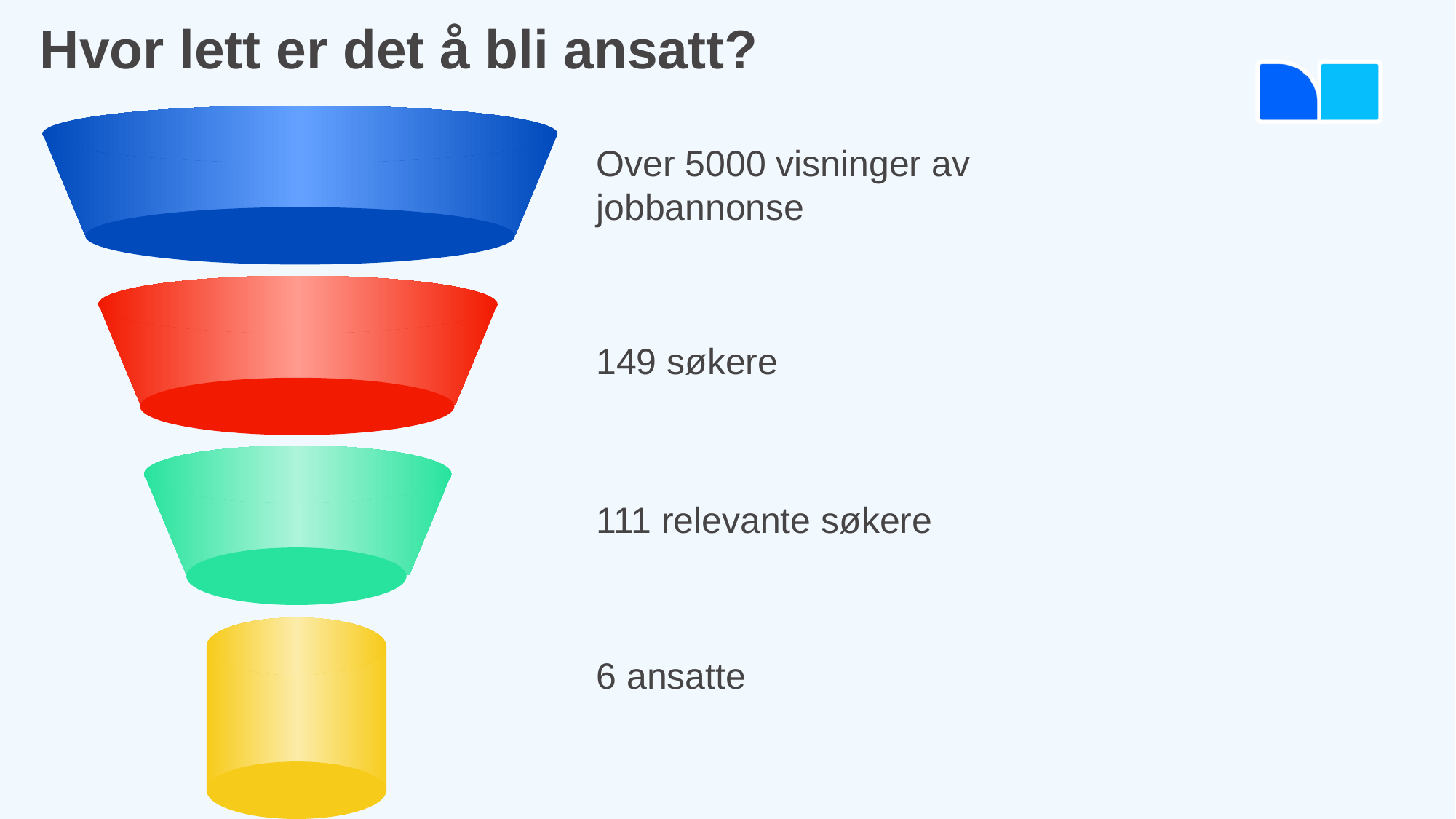
How many ansatte are shown at the bottom of the funnel? 6 What colour is the funnel stage labelled 149 søkere? Red Which is larger, the number of søkere or the number of relevante søkere? søkere How many relevante søkere are shown in the funnel? 111 How many søkere (applicants) are shown in the second stage of the funnel? 149 Do the values decrease or increase from the top of the funnel to the bottom? decrease What is the difference between the number of relevante søkere and the number of ansatte? 105 What does the top stage of the funnel say? Over 5000 visninger av jobbannonse Which stage of the funnel has the smallest value? 6 ansatte What kind of chart is shown on the slide? Funnel chart What is the difference between the number of søkere and the number of relevante søkere? 38 How many stages does the funnel have? 4